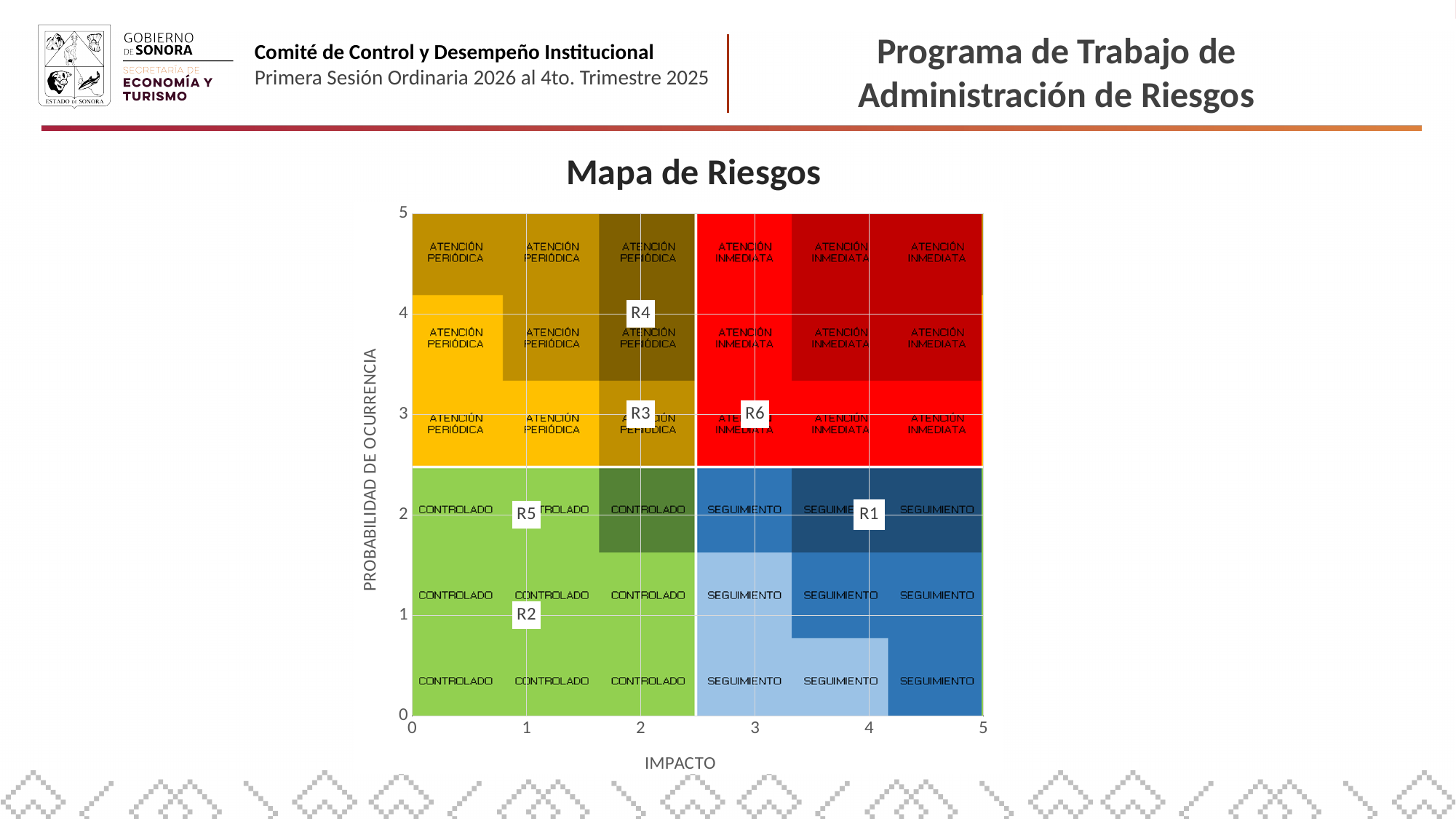
What is the impact (IMPACTO) value for R6? 3 Which risk has the highest probability of occurrence on the Mapa de Riesgos chart? R4 How many risks (R points) are plotted on the Mapa de Riesgos chart? 6 Which risk has the highest impact value on the Mapa de Riesgos chart? R1 Which risk has the lowest probability of occurrence on the Mapa de Riesgos chart? R2 What is the title of the chart on the slide? Mapa de Riesgos What is the impact (IMPACTO) value for R1? 4 What is the difference in probability of occurrence between R4 and R3? 1 Which has a higher impact value, R5 or R6? R6 What is the probability of occurrence value for R2? 1 What is the probability of occurrence (PROBABILIDAD DE OCURRENCIA) value for R4? 4 What is the label of the horizontal axis of the Mapa de Riesgos chart? IMPACTO